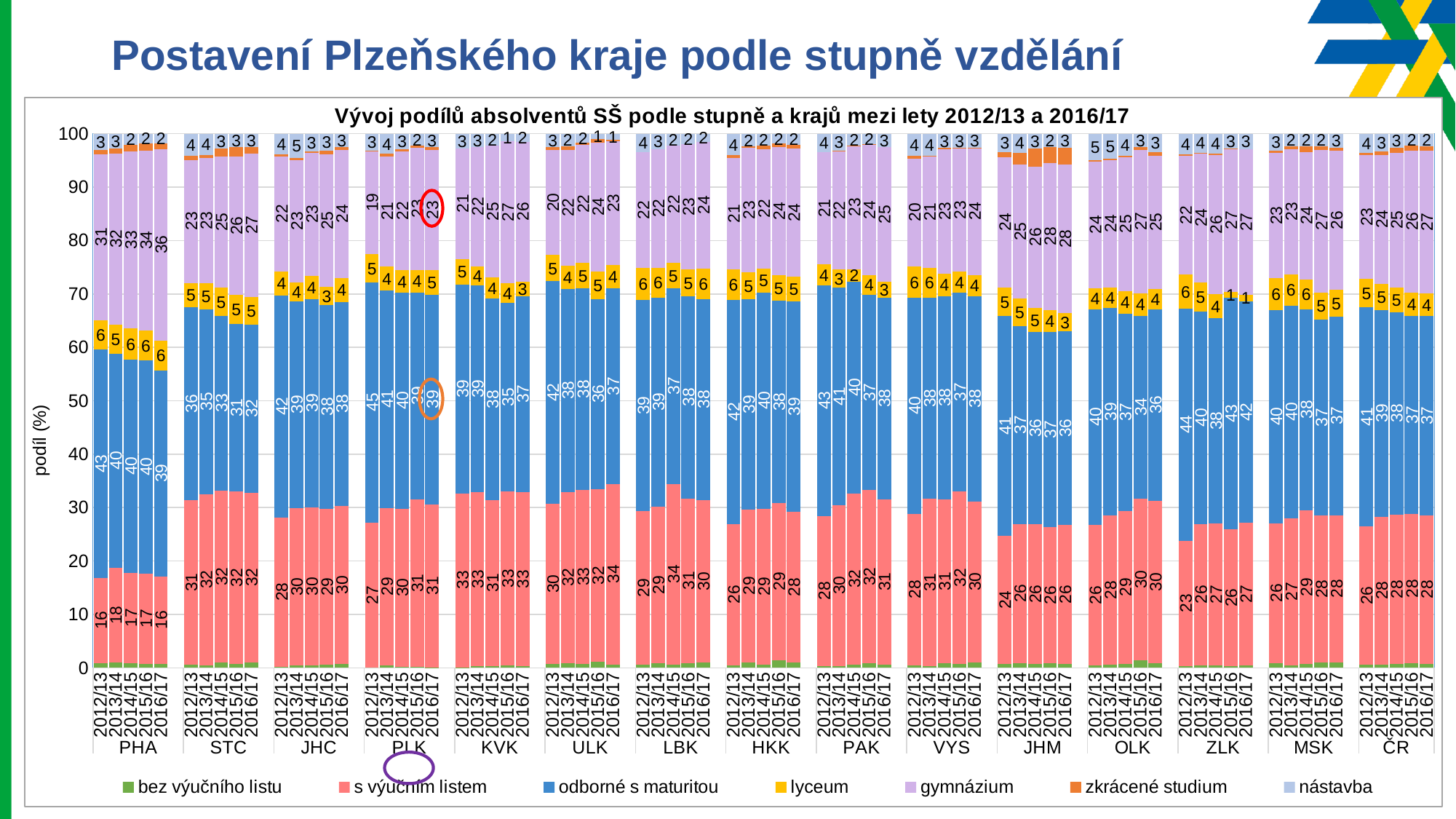
Which region has the highest gymnázium share in 2016/17? PHA How many region groups are shown along the x axis? 15 What is the gymnázium share for PHA in 2016/17? 36 Does the gymnázium share for PHA rise or fall from 2012/13 to 2016/17? rise What is the odborné s maturitou share for ZLK in 2012/13? 44 What is the title of the chart? Vývoj podílů absolventů SŠ podle stupně a krajů mezi lety 2012/13 a 2016/17 Which has the larger s výučním listem share in 2016/17, ULK or PHA? ULK How many series does the legend list? 7 What is the gymnázium share for PLK in 2016/17? 23 What is the s výučním listem share for ČR in 2016/17? 28 By how much did the gymnázium share for PHA change between 2012/13 (31) and 2016/17 (36)? 5 What kind of chart is shown on the slide? stacked bar chart